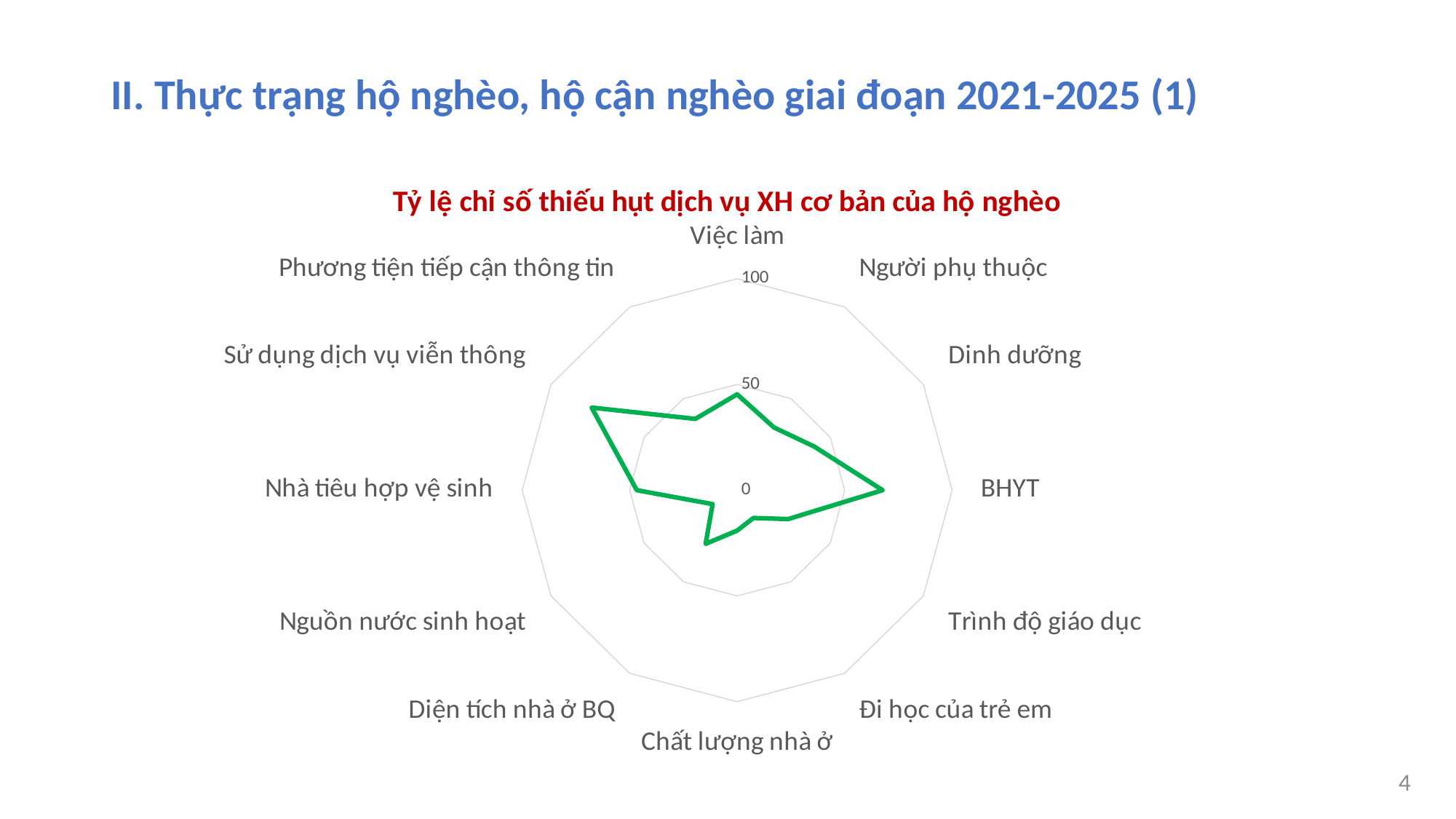
Is the value for Trình độ giáo dục greater or less than 50? less Is the value for Sử dụng dịch vụ viễn thông greater or less than 50? greater Is the value for BHYT greater or less than 50? greater What is the title of the chart? Tỷ lệ chỉ số thiếu hụt dịch vụ XH cơ bản của hộ nghèo How many categories (axes) does the radar chart have? 12 Which is larger, the value for BHYT or the value for Trình độ giáo dục? BHYT Which category has the highest value on the chart? Sử dụng dịch vụ viễn thông What is the maximum value shown on the chart's axis scale? 100 What kind of chart is shown on the slide? Radar chart Which is larger, the value for Sử dụng dịch vụ viễn thông or the value for BHYT? Sử dụng dịch vụ viễn thông